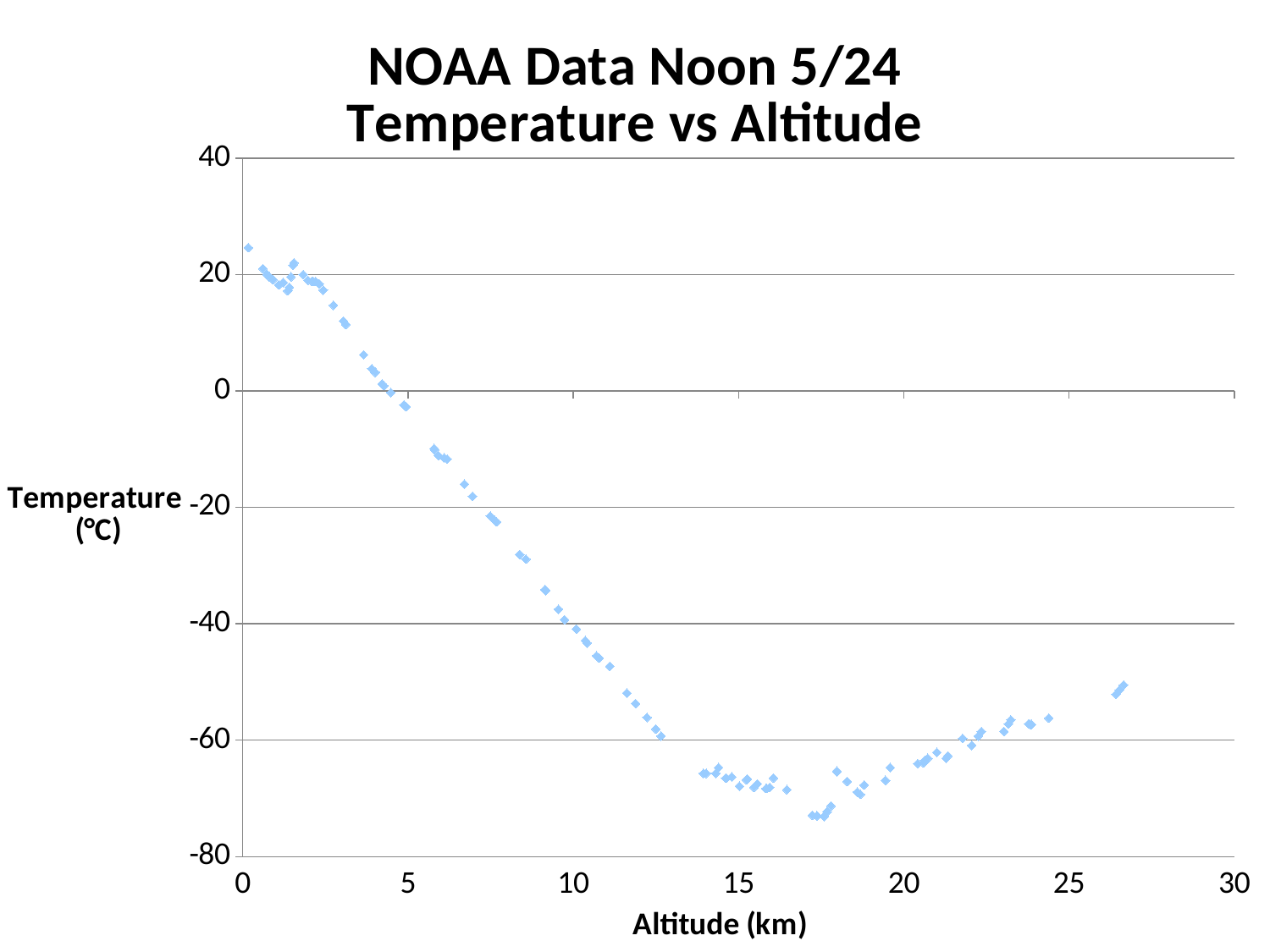
Is the temperature at an altitude of 20 km greater or less than -60 °C? less Is the lowest temperature on the chart reached at an altitude greater or less than 15 km? greater Is the temperature at an altitude of 0 km greater or less than 20 °C? greater Does the temperature rise or fall as altitude increases from 20 km to 27 km? rise Which is higher: the temperature at 5 km altitude or the temperature at 10 km altitude? 5 km What kind of chart is shown on the slide? Scatter chart Does the temperature rise or fall as altitude increases from 0 km to 15 km? fall What is the title of the chart? NOAA Data Noon 5/24 Temperature vs Altitude What quantity is plotted on the x axis of the chart? Altitude (km)